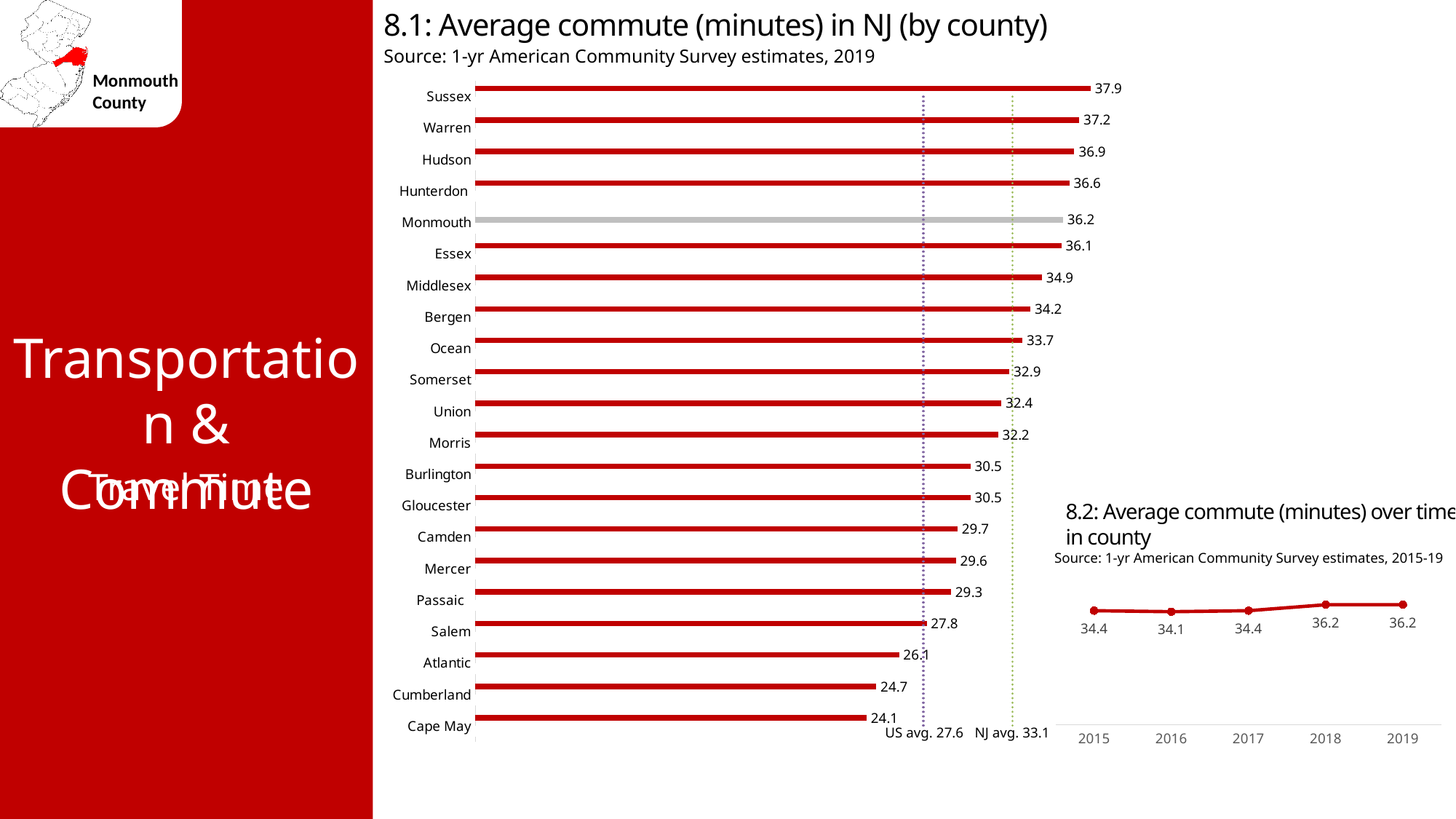
In chart 8.1 (Average commute in NJ by county), which county has the highest average commute? Sussex In chart 8.1 (Average commute in NJ by county), what is the average commute for Monmouth? 36.2 In chart 8.2 (Average commute over time in county), what is the value for 2016? 34.1 What kind of chart is chart 8.1 (Average commute in NJ by county)? bar chart In chart 8.1 (Average commute in NJ by county), what is the difference between the values for Sussex and Cape May? 13.8 In chart 8.1 (Average commute in NJ by county), which has a longer average commute, Hudson or Bergen? Hudson In chart 8.2 (Average commute over time in county), how many years are plotted? 5 In chart 8.1 (Average commute in NJ by county), how many counties are shown? 21 In chart 8.1 (Average commute in NJ by county), what is the value for Cumberland? 24.7 In chart 8.1 (Average commute in NJ by county), which county has the lowest average commute? Cape May In chart 8.1 (Average commute in NJ by county), what is the NJ average shown by the dotted reference line? 33.1 In chart 8.2 (Average commute over time in county), what is the difference between the 2019 value and the 2015 value? 1.8